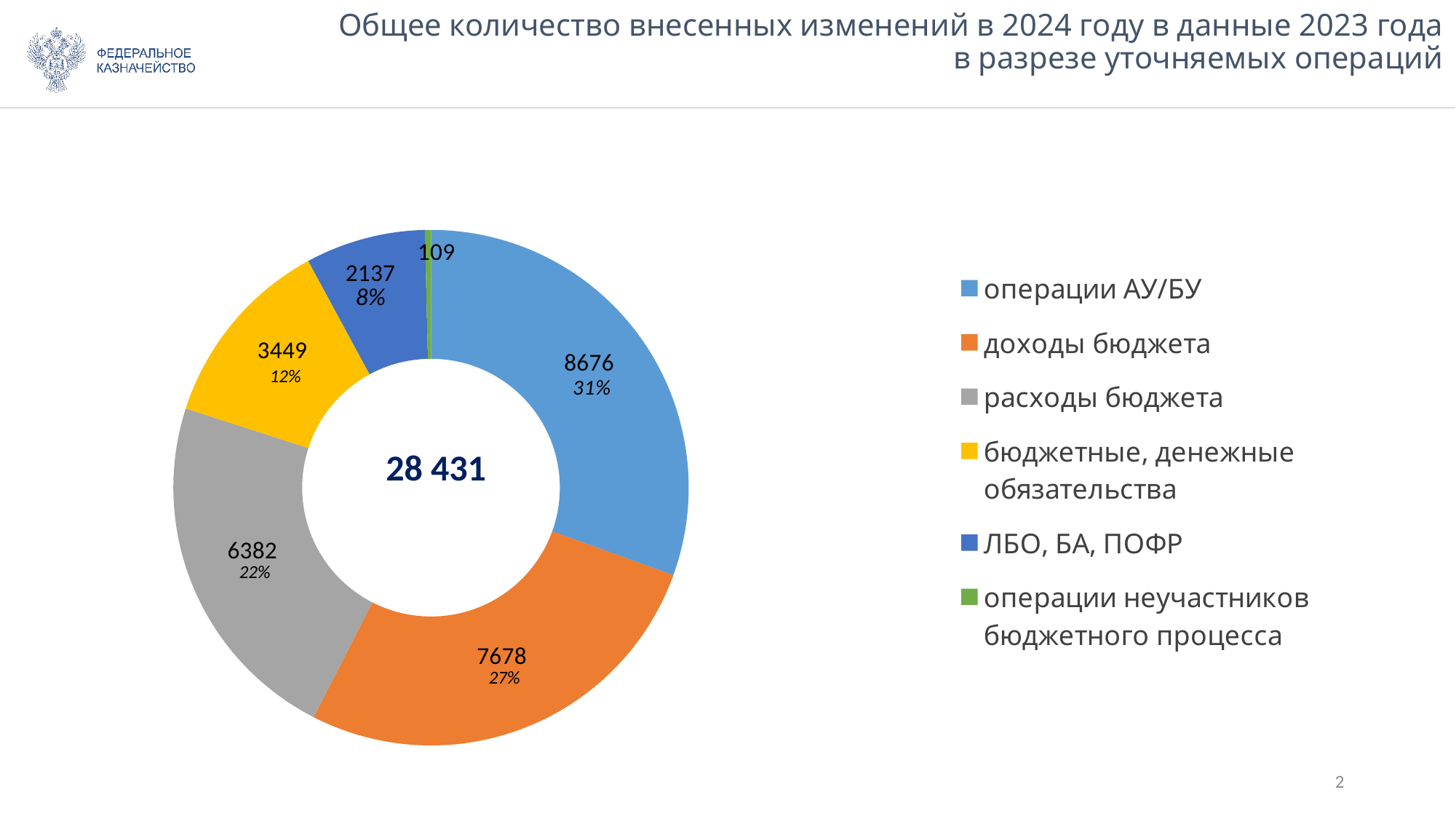
How many categories does the legend list? 6 Which category has the highest value? операции АУ/БУ What is the difference between the values for операции АУ/БУ and доходы бюджета? 998 What is the value for операции АУ/БУ? 8676 What is the value for расходы бюджета? 6382 Which is larger, the value for расходы бюджета or the value for бюджетные, денежные обязательства? расходы бюджета What is the value for доходы бюджета? 7678 Which category has the lowest value? операции неучастников бюджетного процесса What share of the pie does ЛБО, БА, ПОФР represent? 8% What type of chart is shown on the slide? pie chart (donut) What share of the pie does бюджетные, денежные обязательства represent? 12% What is the value for операции неучастников бюджетного процесса? 109